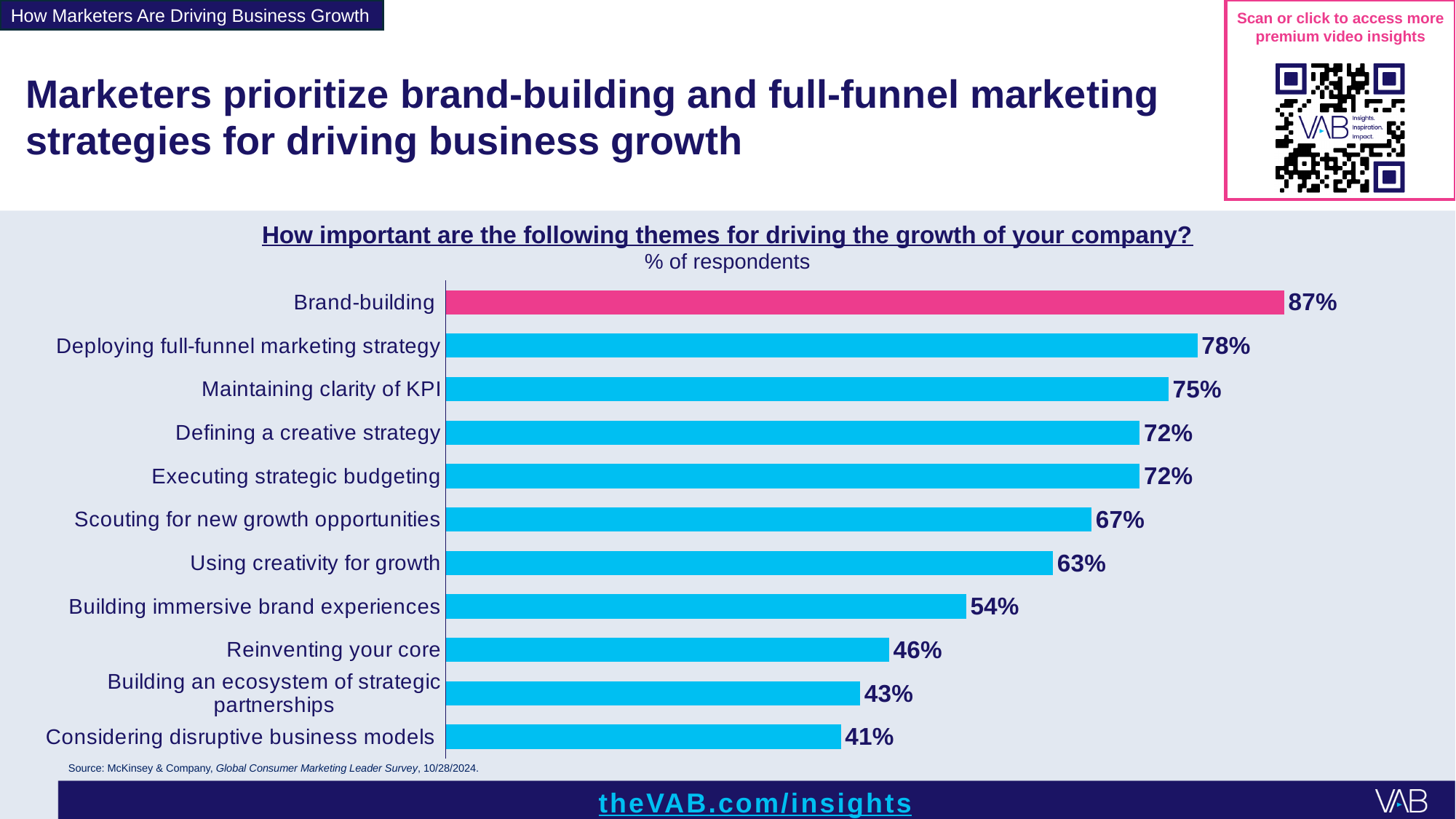
How many themes are shown in the chart? 11 What kind of chart is shown on the slide? Bar chart Which theme has the lowest percentage of respondents? Considering disruptive business models What is the difference between Brand-building and Deploying full-funnel marketing strategy? 9% What percentage of respondents rated Brand-building as important for driving growth? 87% What is the value for Building immersive brand experiences? 54% Which is larger, Scouting for new growth opportunities or Using creativity for growth? Scouting for new growth opportunities Which bar is highlighted in a different colour (pink) from the others? Brand-building Which two themes share the same value of 72%? Defining a creative strategy and Executing strategic budgeting Which theme has the highest percentage of respondents? Brand-building What is the value for Maintaining clarity of KPI? 75% What is the difference between Using creativity for growth and Reinventing your core? 17%